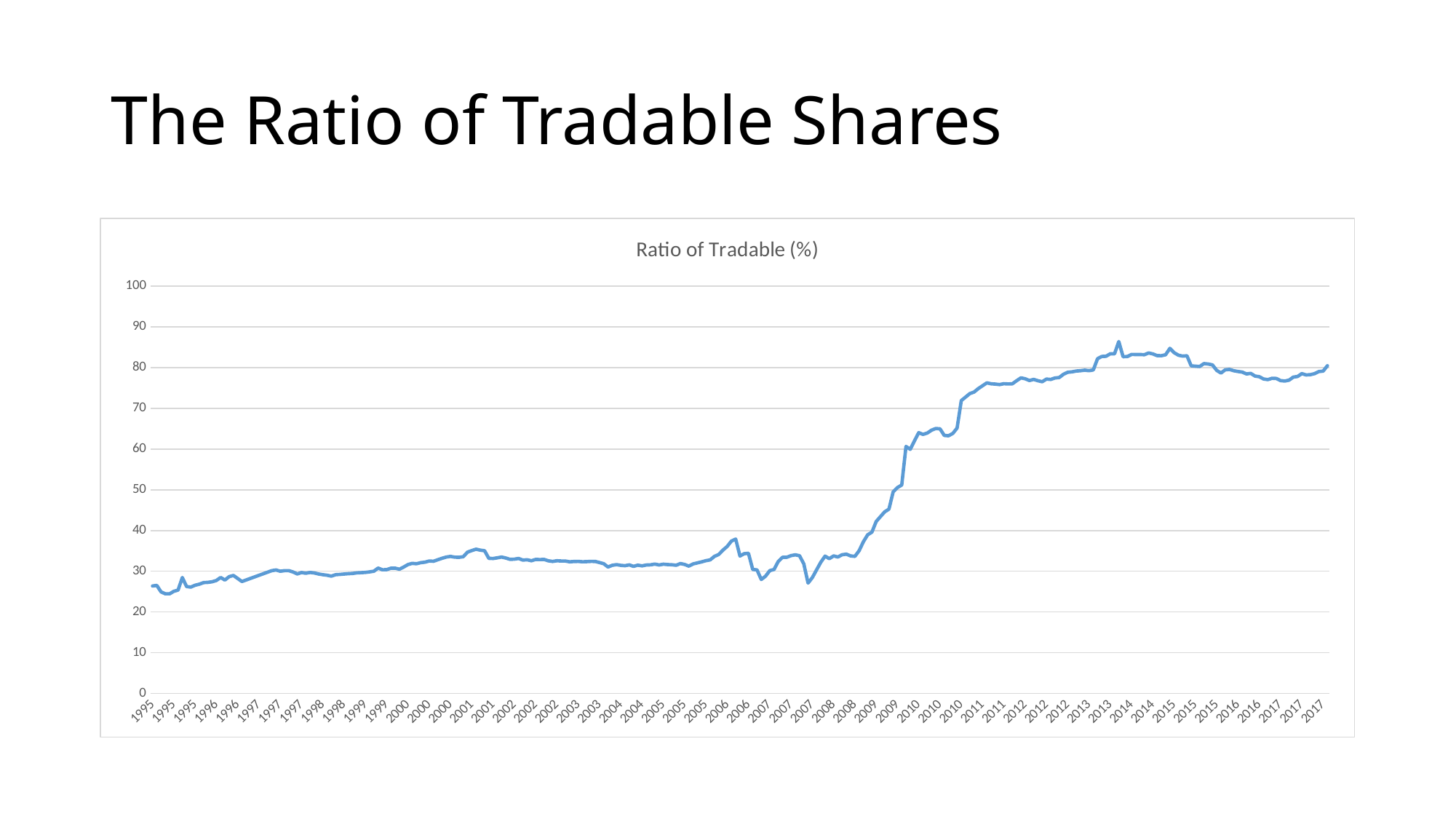
Overall, does the ratio of tradable shares rise or fall from 1995 to 2017? rise Is the value at the start of the series in 1995 greater or less than 30? less What is the highest value shown on the vertical axis? 100 Does the line rise or fall between 2008 and 2010? rise What is the title of the chart? Ratio of Tradable (%) Is the value in 2001 greater or less than 40? less What kind of chart is shown on the slide? line chart Is the value in 2017 larger or smaller than the value in 1995? larger Is the value in 2011 greater or less than 70? greater In which year does the line reach its highest point? 2013